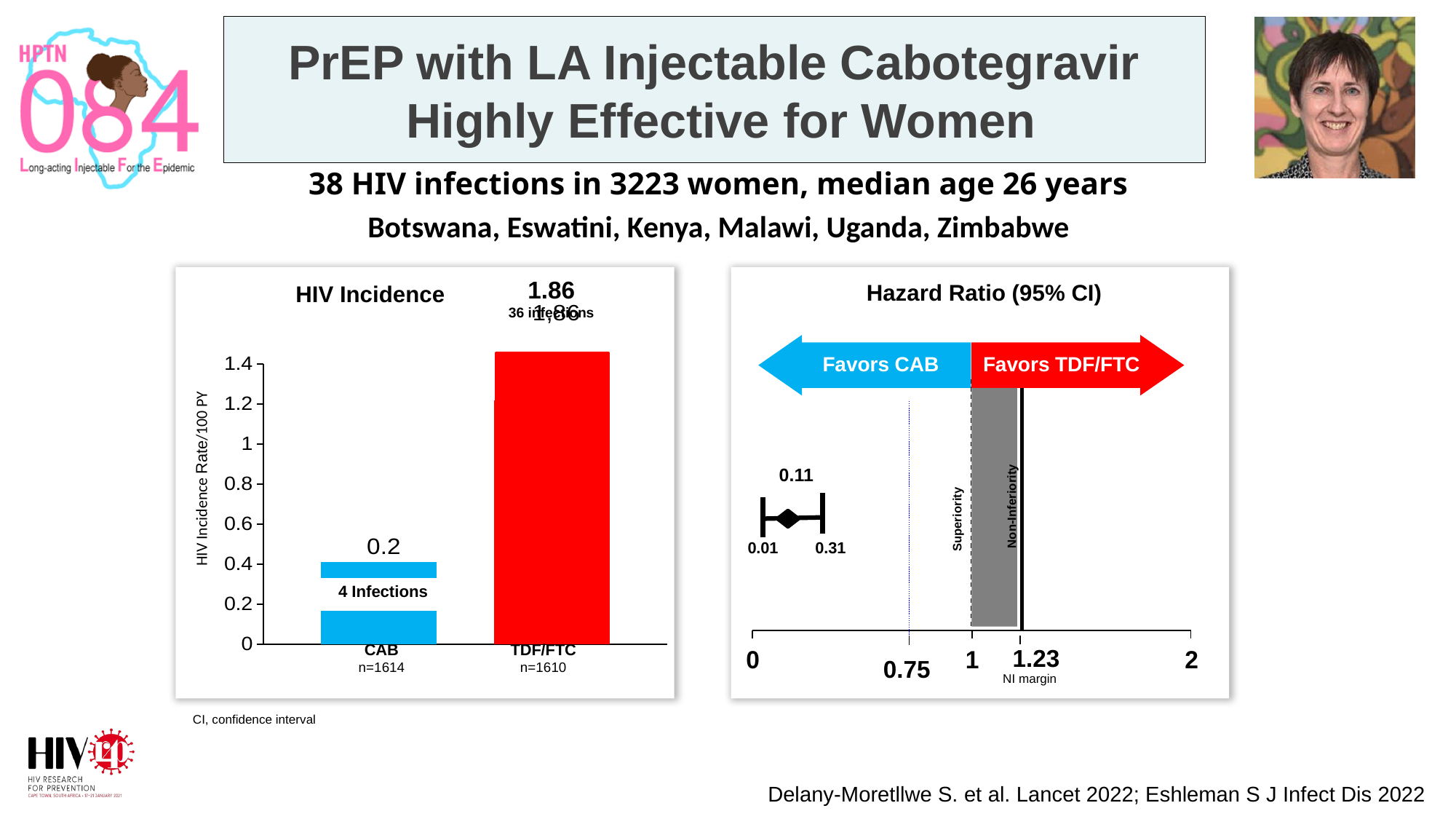
In the HIV Incidence chart, what is the difference between the TDF/FTC and CAB incidence rates? 1.66 In the HIV Incidence chart, what is the HIV incidence rate per 100 PY for CAB? 0.2 How many arms (bars) are shown in the HIV Incidence chart? 2 In the HIV Incidence chart, which arm has the lower incidence rate? CAB In the HIV Incidence chart, which arm has the higher incidence rate? TDF/FTC In the HIV Incidence chart, how many infections are reported for the CAB arm? 4 Infections In the Hazard Ratio (95% CI) chart, what is the hazard ratio point estimate? 0.11 In the Hazard Ratio (95% CI) chart, what value is marked as the NI margin? 1.23 In the HIV Incidence chart, what is the HIV incidence rate per 100 PY for TDF/FTC? 1.86 In the HIV Incidence chart, is the value for TDF/FTC greater or less than 1? greater In the Hazard Ratio (95% CI) chart, what are the lower and upper bounds of the 95% confidence interval? 0.01 and 0.31 What kind of chart is the HIV Incidence chart on the left? bar chart